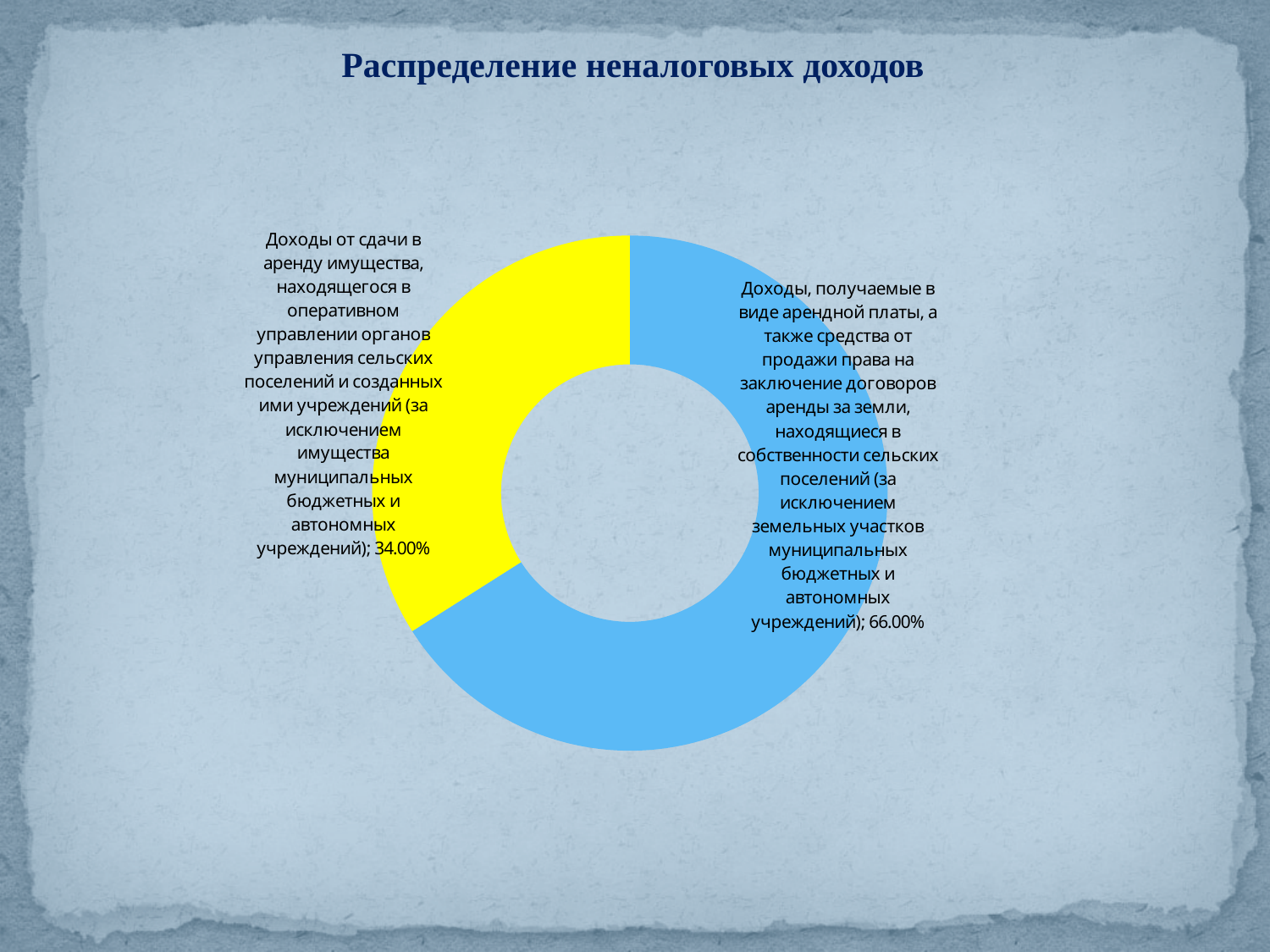
How many slices does the chart have? 2 What share of non-tax income comes from rent payments and sale of rights to conclude lease agreements for land owned by rural settlements (Доходы, получаемые в виде арендной платы...)? 66.00% What is the title of the chart? Распределение неналоговых доходов Which category has the largest share of non-tax income? Доходы, получаемые в виде арендной платы, а также средства от продажи права на заключение договоров аренды за земли What colour is the slice representing 34.00%? Yellow Which category has the smallest share of non-tax income? Доходы от сдачи в аренду имущества, находящегося в оперативном управлении What share of non-tax income comes from leasing property in the operational management of rural settlement bodies and their institutions (Доходы от сдачи в аренду имущества...)? 34.00% What is the total of the two slices shown in the chart? 100.00% By how many percentage points does the share for land rent income (66.00%) exceed the share for property lease income (34.00%)? 32.00% What kind of chart is shown on the slide? Doughnut (pie) chart Which is larger: the share for land rent income or the share for property lease income? Land rent income (Доходы, получаемые в виде арендной платы) What is the share of the blue slice in the chart? 66.00%